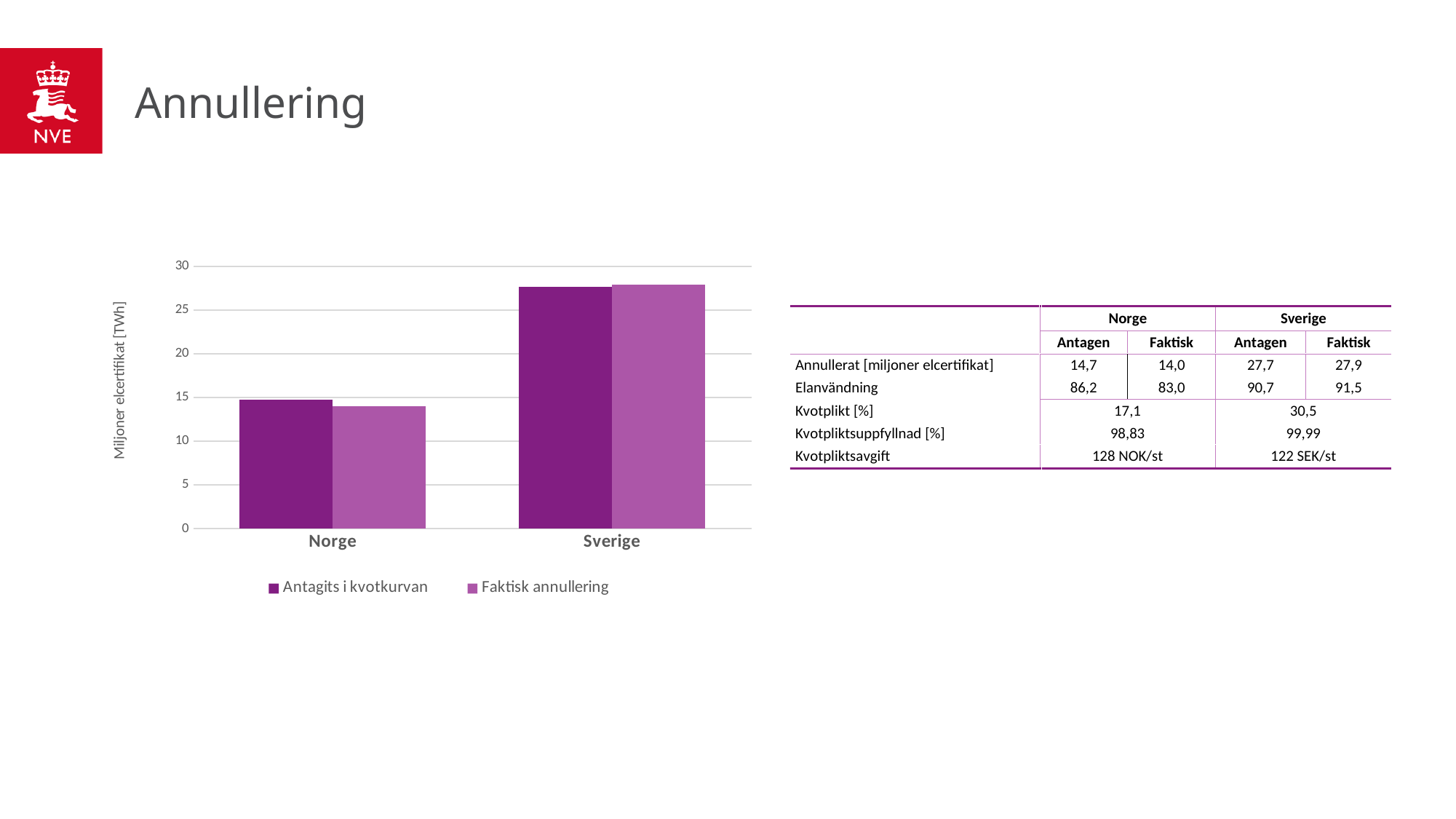
How many series does the chart legend list? 2 Is the value for Antagits i kvotkurvan for Norge greater or less than 10? greater Is the value for Faktisk annullering for Sverige greater or less than 30? less Is the value for Antagits i kvotkurvan for Norge greater or less than 20? less What is the label of the y axis of the chart? Miljoner elcertifikat [TWh] How many categories are shown on the x axis of the chart? 2 Which category has the taller bars in the chart, Norge or Sverige? Sverige What are the two series named in the chart legend? Antagits i kvotkurvan and Faktisk annullering What kind of chart is shown on the slide? bar chart